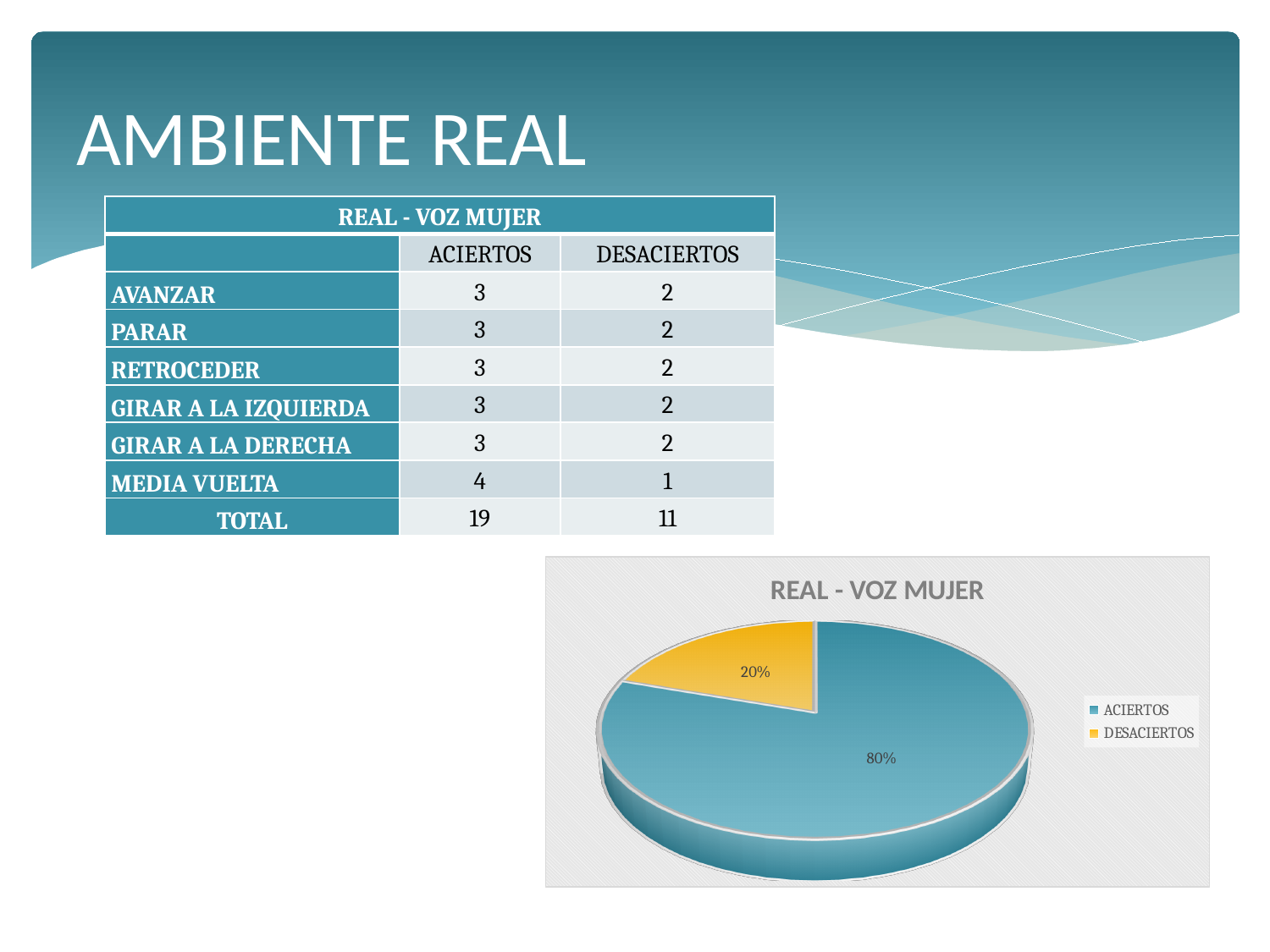
Which is larger in the pie chart, ACIERTOS or DESACIERTOS? ACIERTOS What colour is the DESACIERTOS slice in the pie chart? yellow What share of the pie does DESACIERTOS represent? 20% Which slice of the pie is the smallest? DESACIERTOS What kind of chart is shown on the slide? pie chart What share of the pie does ACIERTOS represent? 80% How many slices does the pie chart have? 2 What is the difference in percentage points between the ACIERTOS and DESACIERTOS slices? 60 percentage points Which slice of the pie is the largest? ACIERTOS What is the title of the chart? REAL - VOZ MUJER How many entries does the chart legend list? 2